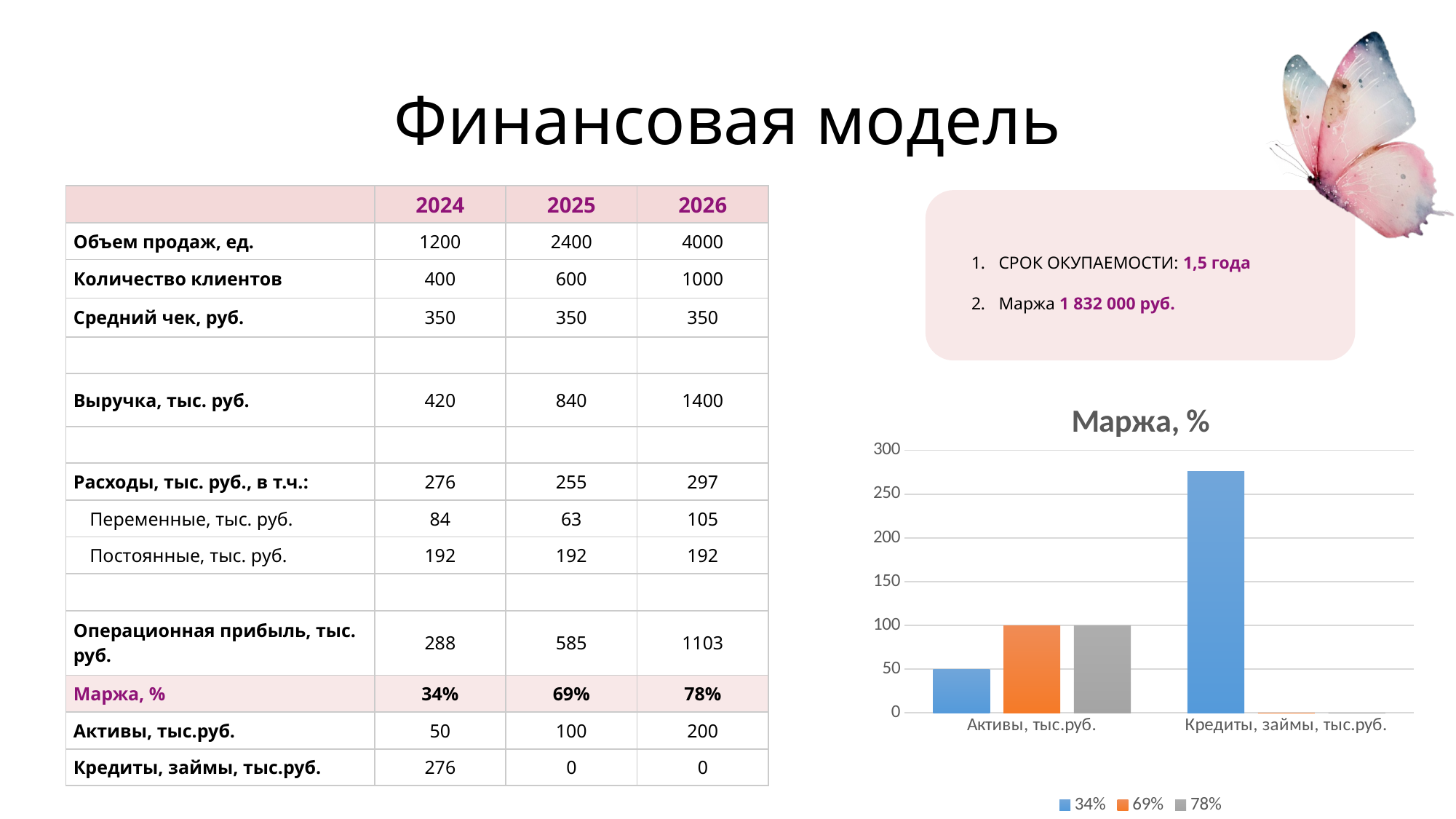
How many categories are shown on the x axis of the chart? 2 How many series does the chart legend list? 3 Which series has the smallest bar for Активы, тыс.руб.? 34% Is the value of the 34% series for Кредиты, займы, тыс.руб. greater or less than 250? greater What kind of chart is shown on the slide? bar chart What are the legend entries of the chart? 34%, 69%, 78% Is the value of the 34% series for Активы, тыс.руб. greater or less than 100? less For Кредиты, займы, тыс.руб., which series has the larger value: 34% or 69%? 34% Which category contains the tallest bar in the chart? Кредиты, займы, тыс.руб. What is the title of the chart? Маржа, % Is the value of the 69% series for Активы, тыс.руб. greater or less than 150? less For Активы, тыс.руб., which series has the larger value: 34% or 69%? 69%